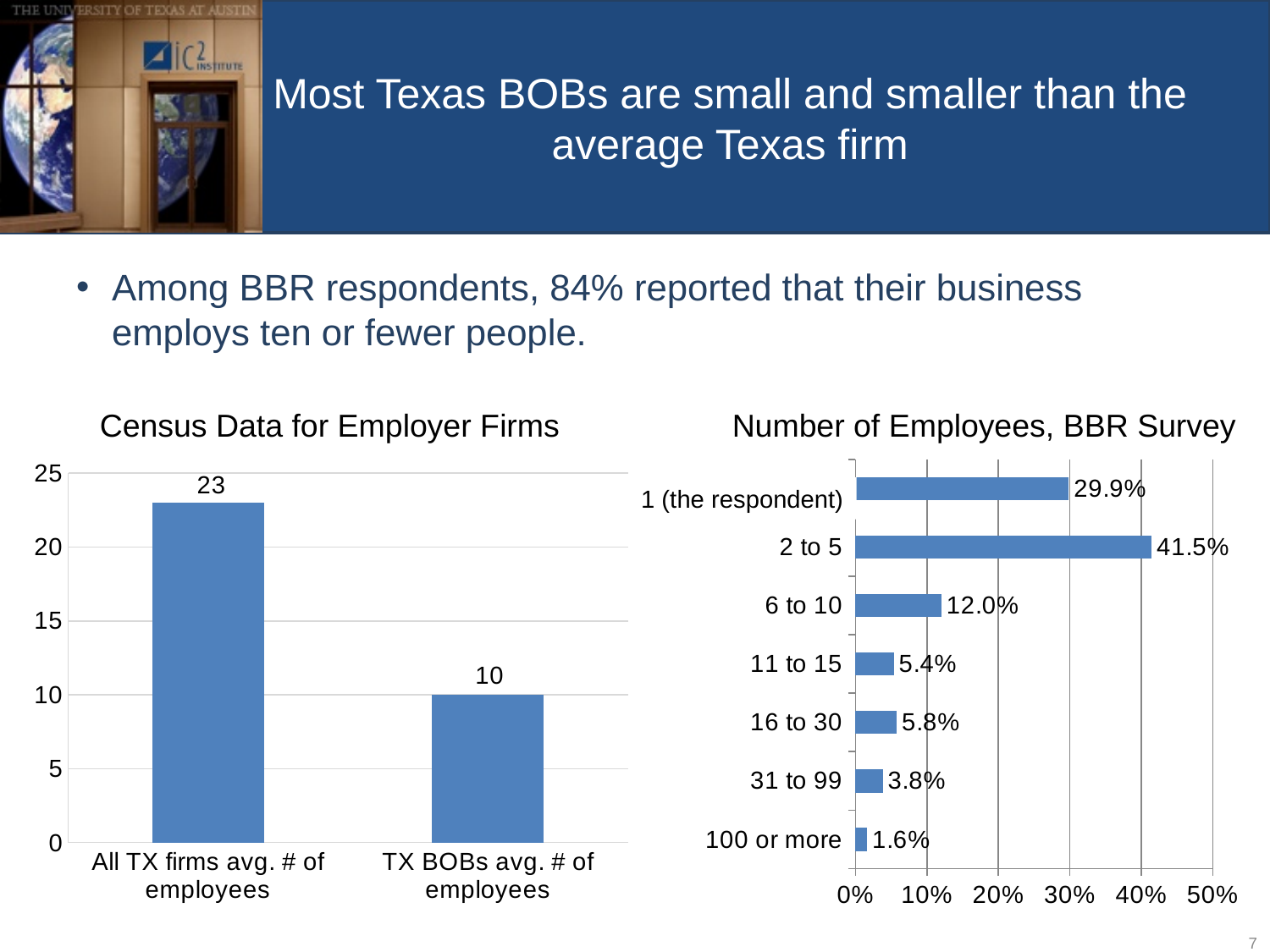
In the 'Number of Employees, BBR Survey' chart, how many categories are shown? 7 In the 'Census Data for Employer Firms' chart, which category has the higher value? All TX firms avg. # of employees In the 'Number of Employees, BBR Survey' chart, is the value for '1 (the respondent)' greater or less than 20%? greater In the 'Census Data for Employer Firms' chart, what is the value for 'TX BOBs avg. # of employees'? 10 In the 'Number of Employees, BBR Survey' chart, what is the value for '100 or more'? 1.6% What kind of chart is the 'Census Data for Employer Firms' chart? Bar chart In the 'Number of Employees, BBR Survey' chart, what is the difference between the values for '1 (the respondent)' and '6 to 10'? 17.9% In the 'Number of Employees, BBR Survey' chart, which category has the lowest value? 100 or more In the 'Census Data for Employer Firms' chart, what is the value for 'All TX firms avg. # of employees'? 23 In the 'Number of Employees, BBR Survey' chart, what is the value for '2 to 5'? 41.5% In the 'Census Data for Employer Firms' chart, what is the difference between the value for all TX firms and the value for TX BOBs? 13 In the 'Number of Employees, BBR Survey' chart, which category has the highest value? 2 to 5